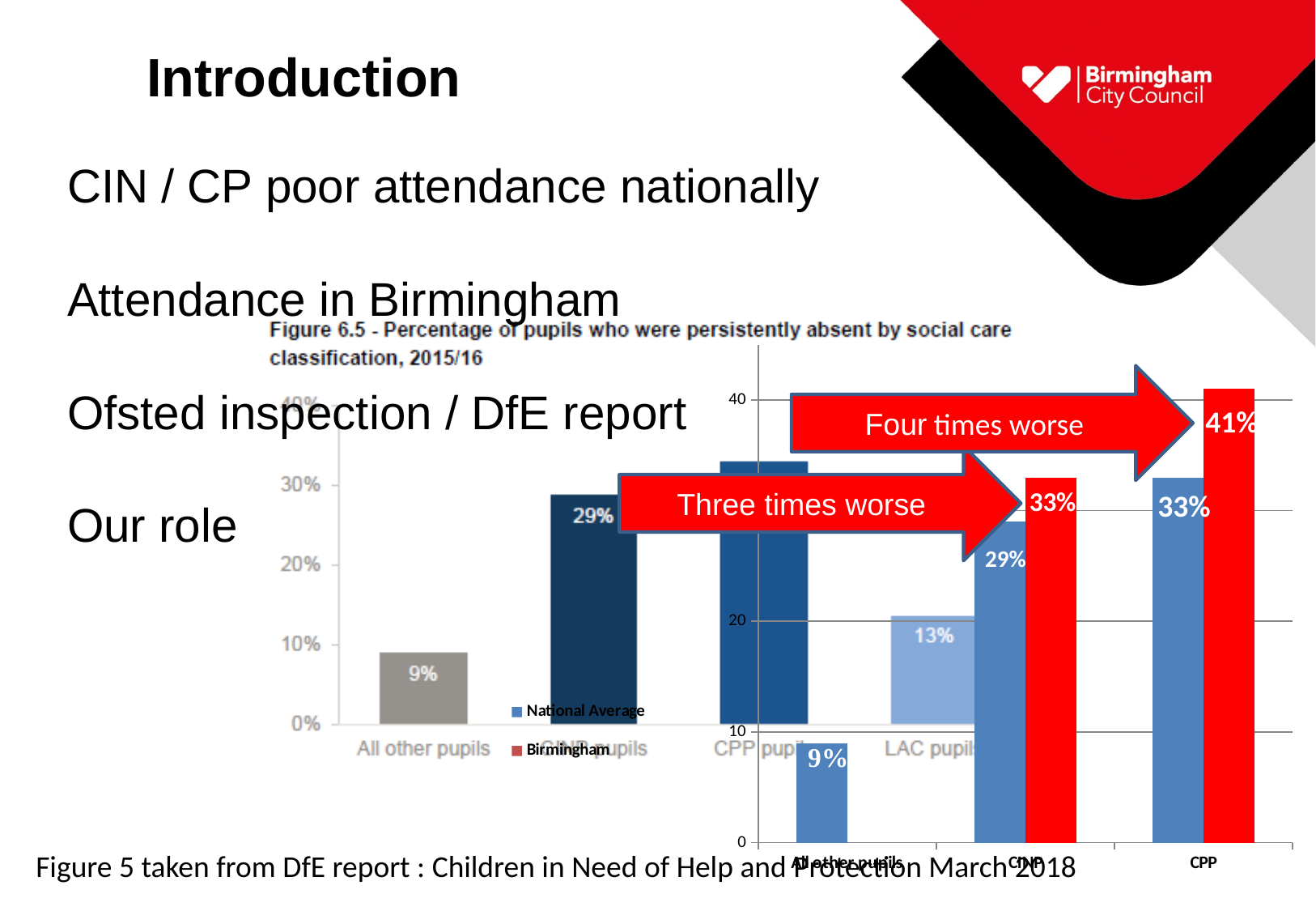
In the Figure 6.5 chart, which category has the lowest percentage of persistently absent pupils? All other pupils In the chart on the right, how many series does the legend list? 2 In the chart on the right, what is the difference between the Birmingham and National Average values for CPP? 8% In the Figure 6.5 chart, which category has the highest bar? CPP pupils In the Figure 6.5 chart, what is the value for CIN pupils? 29% In the chart on the right with the National Average and Birmingham legend, what is the Birmingham value for CPP? 41% In the chart on the right with the National Average and Birmingham legend, what is the Birmingham value for CIN? 33% In the Figure 6.5 chart, what percentage of 'All other pupils' were persistently absent? 9% In the Figure 6.5 chart, what is the difference between the CIN pupils value and the All other pupils value? 20% In the Figure 6.5 chart, what is the value for LAC pupils? 13% In the Figure 6.5 chart, is the value for CPP pupils greater or less than 30%? greater In the chart on the right with the National Average and Birmingham legend, what is the National Average value for CPP? 33%